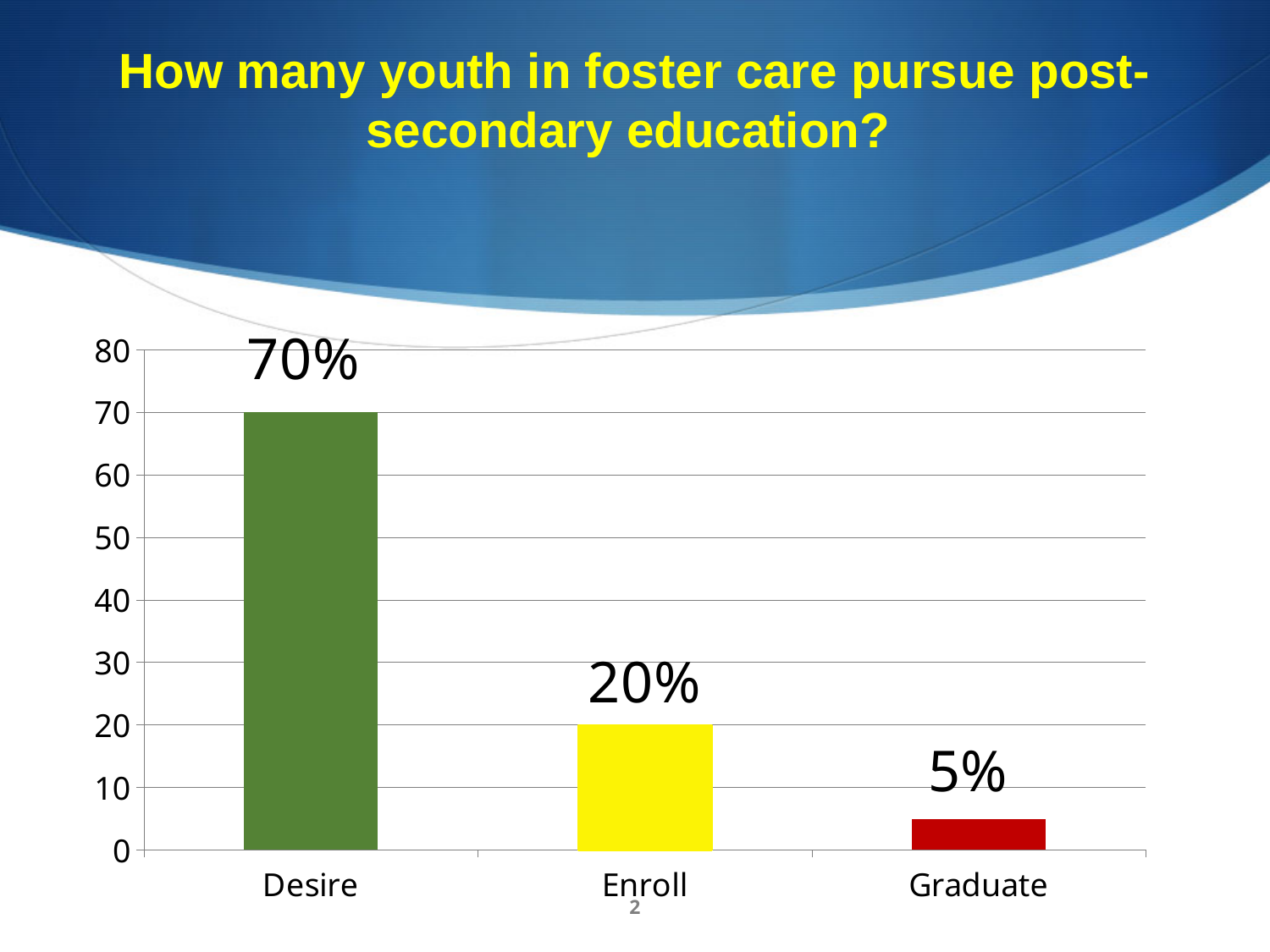
What is the value for Desire? 70% What is the difference between the values for Enroll and Graduate? 15% How many categories are shown on the x axis? 3 What is the value for Enroll? 20% Which category has the highest value? Desire What kind of chart is shown on the slide? bar chart What is the difference between the values for Desire and Enroll? 50% Which is larger, the value for Enroll or the value for Graduate? Enroll Is the value for Desire greater or less than 60? greater Do the values rise or fall from Desire to Graduate along the x axis? fall Which category has the lowest value? Graduate What is the value for Graduate? 5%